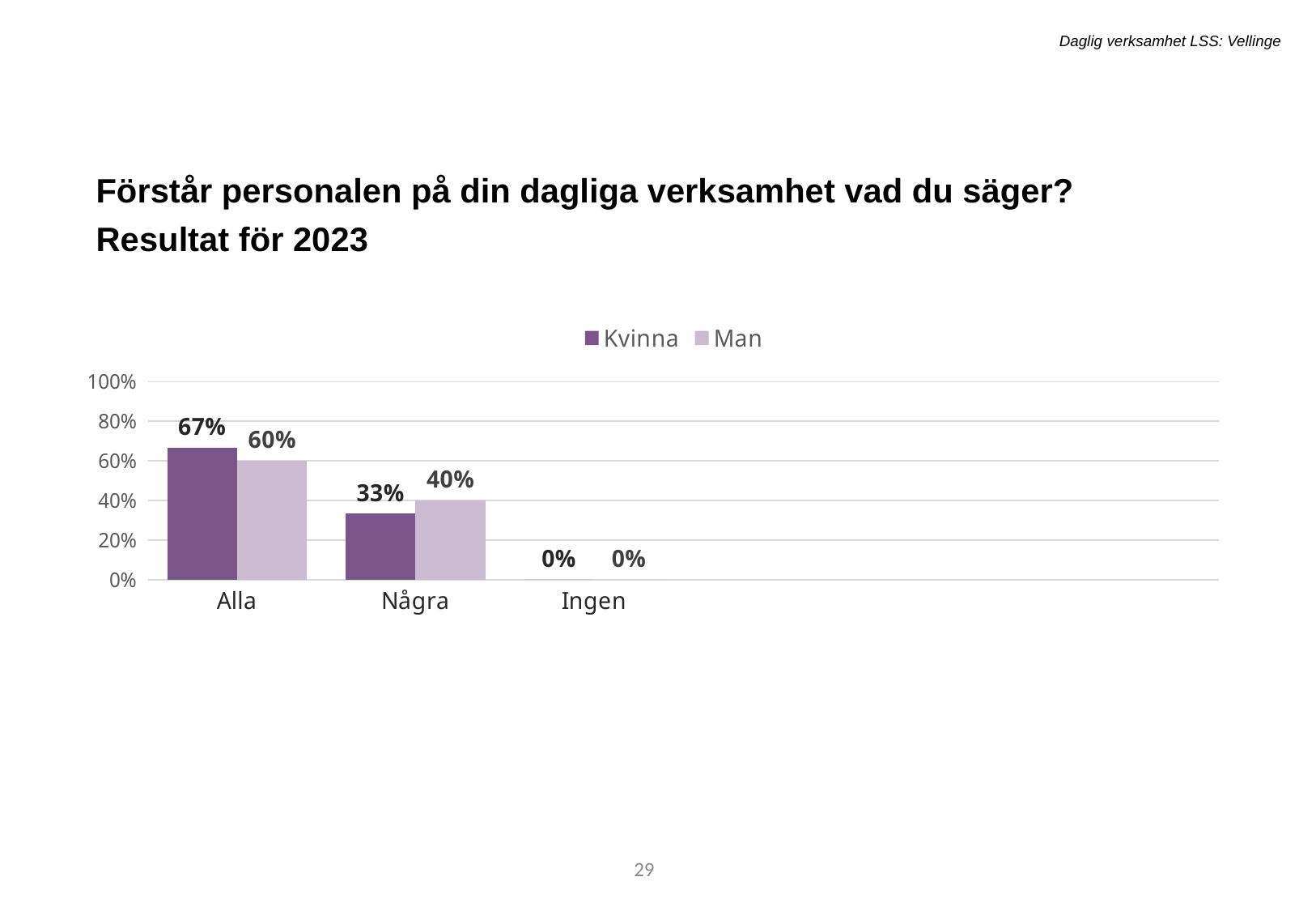
Which category has the highest value for the Man series? Alla What kind of chart is shown on the slide? bar chart Is the value for Man in the Alla category greater or less than 40%? greater What is the value for Kvinna in the Ingen category? 0% In the Några category, which series has the larger value, Kvinna or Man? Man What is the value for Kvinna in the Alla category? 67% How many series does the legend list? 2 How many categories are shown on the x axis? 3 What are the two series named in the legend? Kvinna and Man What is the difference between the Kvinna and Man values in the Alla category? 7% What is the value for Man in the Några category? 40% Which category has the lowest value for the Kvinna series? Ingen